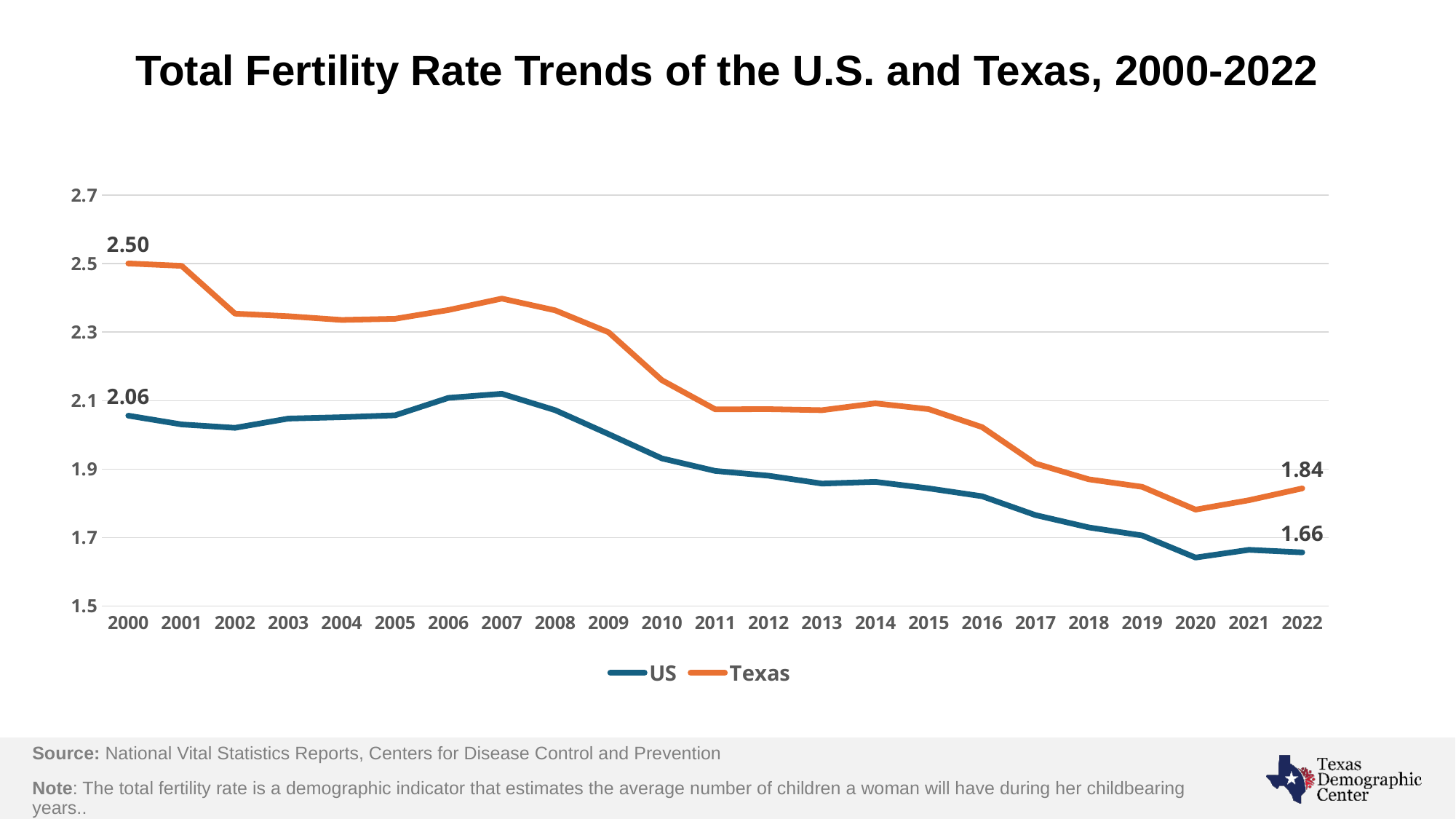
By how much did the Texas total fertility rate fall between 2000 and 2022? 0.66 What is the difference between the Texas and US total fertility rates in 2022? 0.18 What was the total fertility rate for the US in 2022? 1.66 How many series does the legend list? 2 What was the total fertility rate for Texas in 2000? 2.50 What was the total fertility rate for Texas in 2022? 1.84 What kind of chart is shown on the slide? Line chart What was the total fertility rate for the US in 2000? 2.06 In which year was the US total fertility rate at its lowest? 2020 Is the US total fertility rate in 2020 greater or less than 1.7? less Is the Texas total fertility rate in 2007 greater or less than 2.3? greater Which series had the higher total fertility rate in 2022, US or Texas? Texas